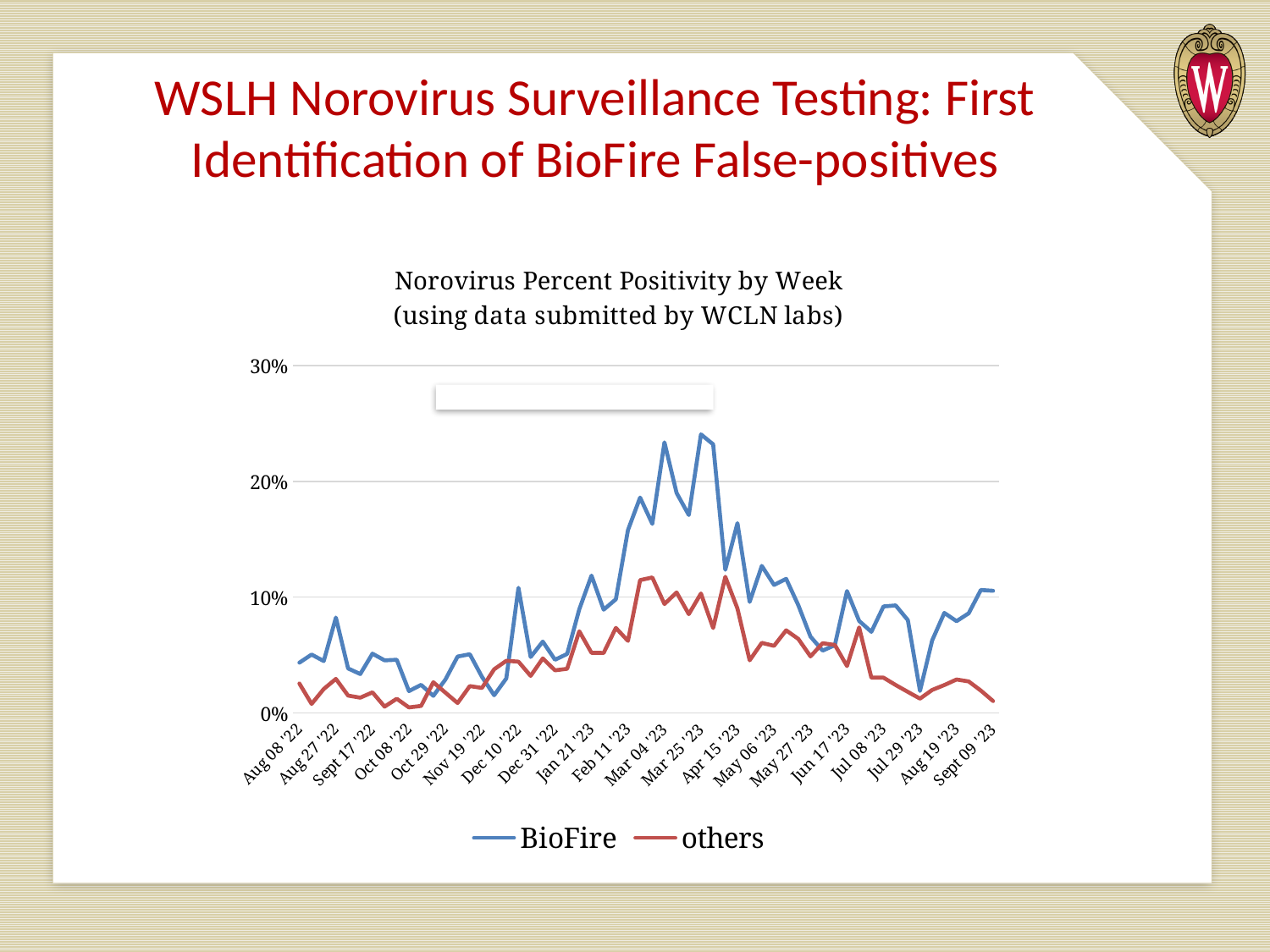
Is the others value at Sept 09 '23 greater or less than 10%? less Is the others value at Mar 04 '23 greater or less than 20%? less What kind of chart is shown on the slide? line chart Which series reaches the highest percent positivity on the chart? BioFire Does the BioFire line rise or fall between Mar 25 '23 and Jul 29 '23? fall What are the two series named in the legend? BioFire and others At Mar 25 '23, which series has the larger value, BioFire or others? BioFire Is the BioFire value at Aug 08 '22 greater or less than 10%? less What is the title of the chart? Norovirus Percent Positivity by Week (using data submitted by WCLN labs) How many series does the legend list? 2 At Jun 17 '23, which series has the larger value, BioFire or others? BioFire